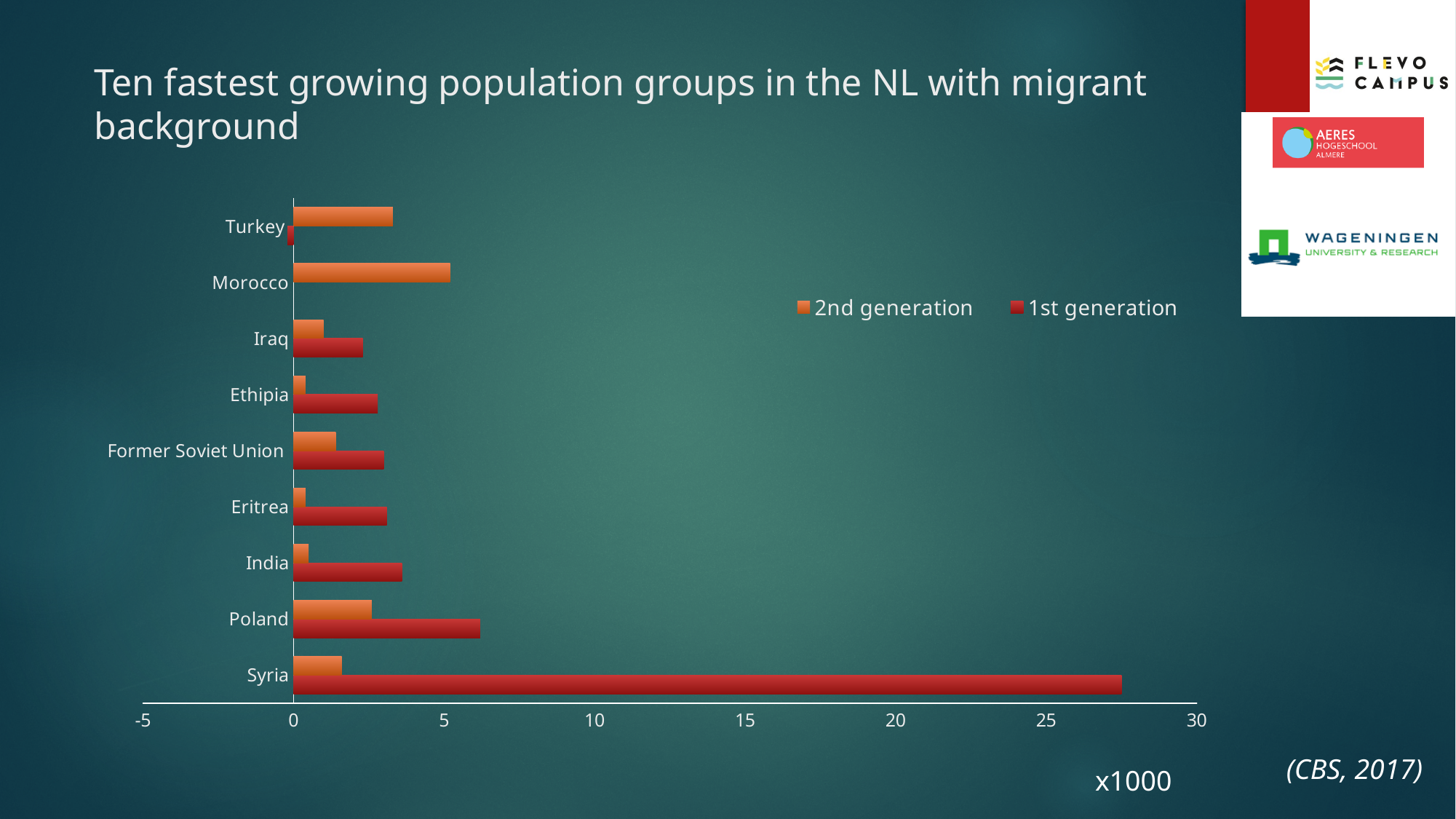
For Turkey, which is larger: the 1st generation value or the 2nd generation value? 2nd generation Is the 2nd generation value for Turkey greater or less than 5? less Which population group has the highest 2nd generation value? Morocco Which population group has the highest 1st generation value? Syria For Poland, which is larger: the 1st generation value or the 2nd generation value? 1st generation How many series does the legend list? 2 What kind of chart is shown on the slide? bar chart How many population groups (categories) are plotted on the chart? 9 Is the 1st generation value for Syria greater or less than 25? greater Is the 1st generation value for Poland greater or less than 5? greater What is the title of the chart on the slide? Ten fastest growing population groups in the NL with migrant background Which population group has the lowest 1st generation value? Turkey